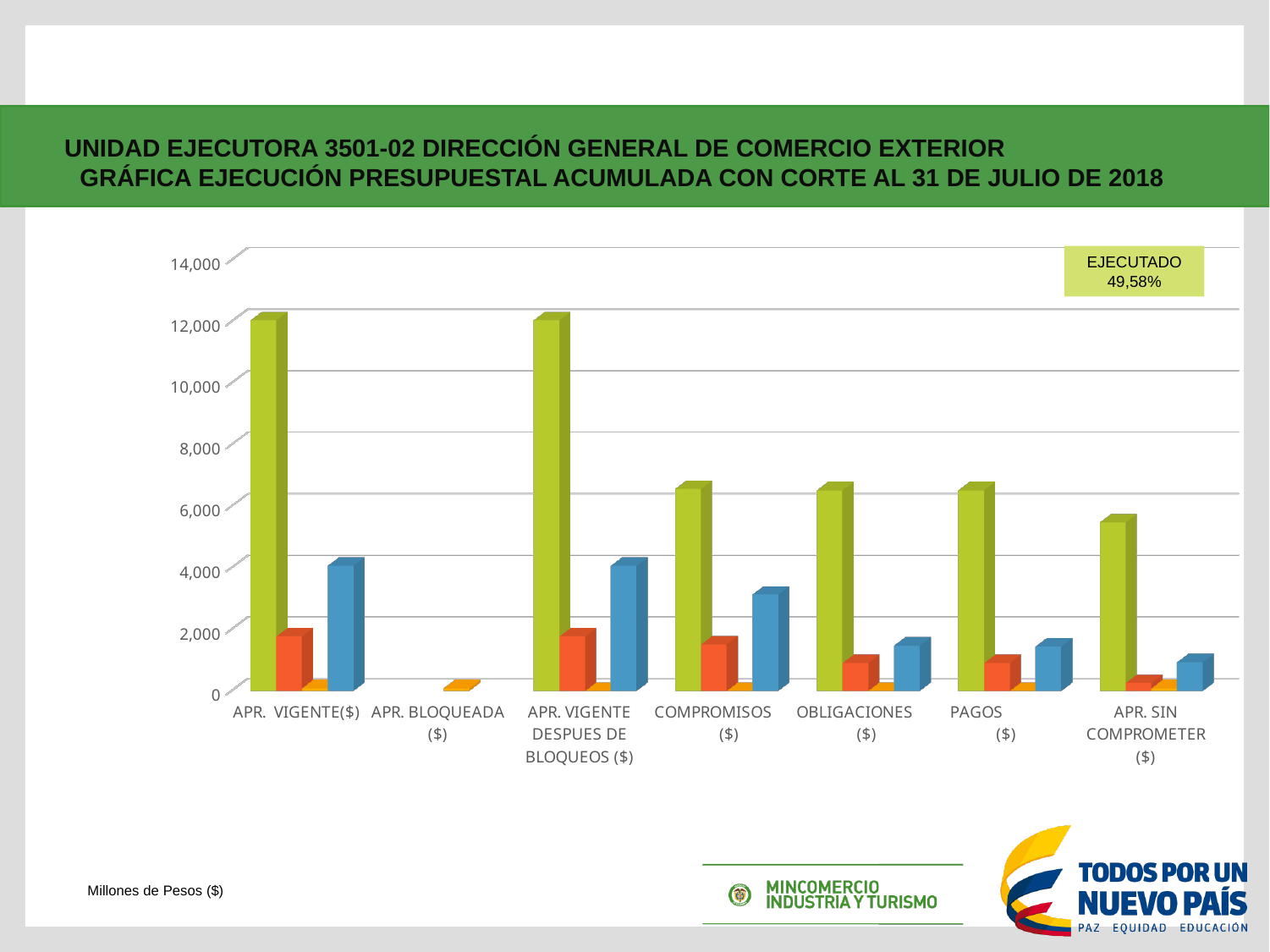
Is the blue bar for APR. VIGENTE($) greater or less than 2,000? greater What kind of chart is shown on the slide? bar chart Is the blue bar for COMPROMISOS ($) greater or less than 4,000? less Is the orange bar for APR. VIGENTE($) greater or less than 4,000? less Which has the taller blue bar, COMPROMISOS ($) or OBLIGACIONES ($)? COMPROMISOS ($) Which has the taller green bar, COMPROMISOS ($) or APR. SIN COMPROMETER ($)? COMPROMISOS ($) What percentage is shown in the EJECUTADO box on the chart? 49,58% How many categories are shown along the x axis of the chart? 7 Which category has the lowest bars in the chart? APR. BLOQUEADA ($)